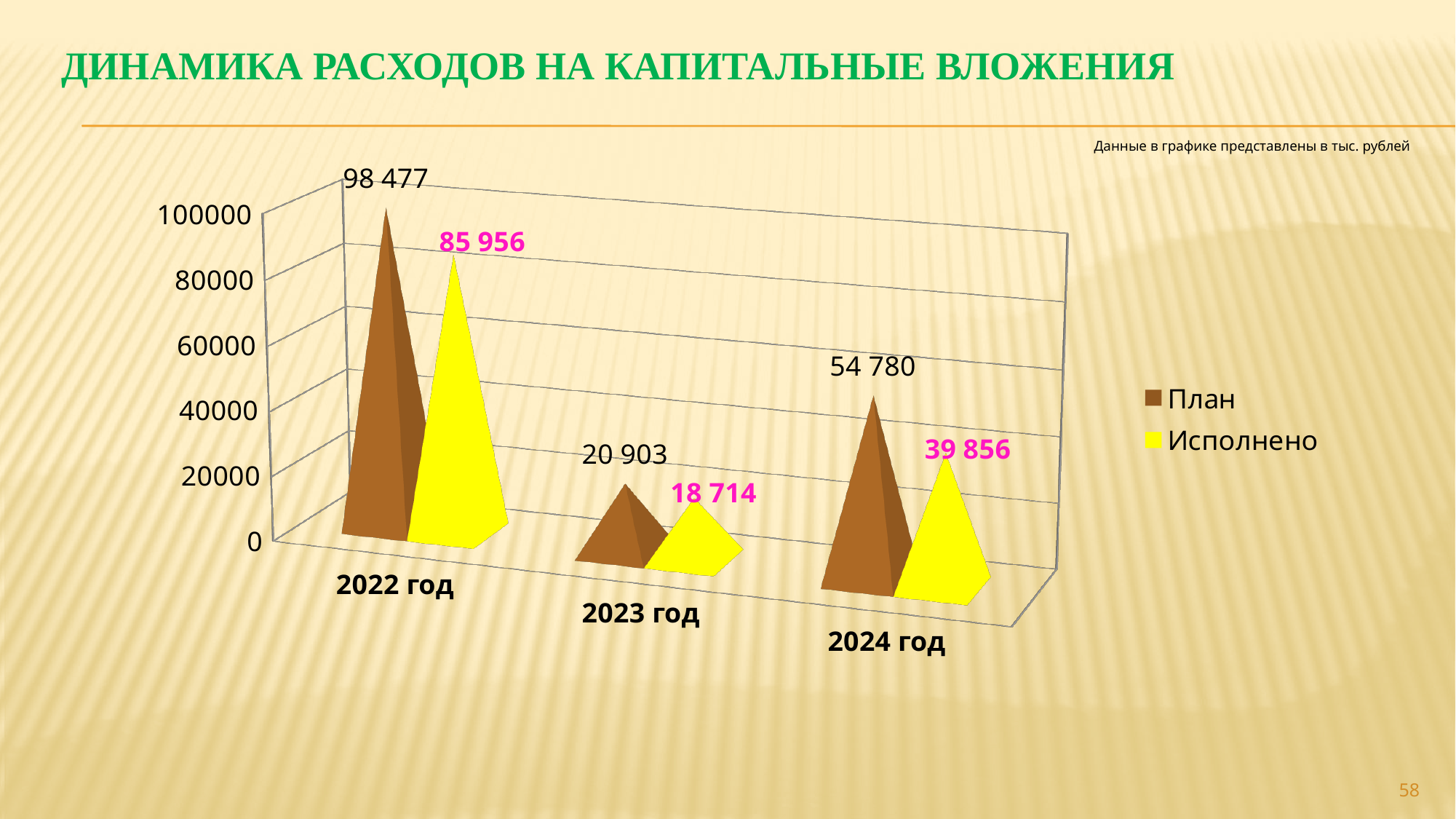
What is the difference between the План and Исполнено values for 2022 год? 12 521 How many series does the legend list? 2 What is the Исполнено value for 2023 год? 18 714 What is the План value for 2022 год? 98 477 How many years are shown on the x axis? 3 Which year has the highest План value? 2022 год Does the План value rise or fall from 2022 год to 2023 год? Fall What is the Исполнено value for 2024 год? 39 856 Which year has the lowest Исполнено value? 2023 год What is the difference between the План and Исполнено values for 2024 год? 14 924 What kind of chart is shown on the slide? Bar chart Which is larger for 2023 год, План or Исполнено? План